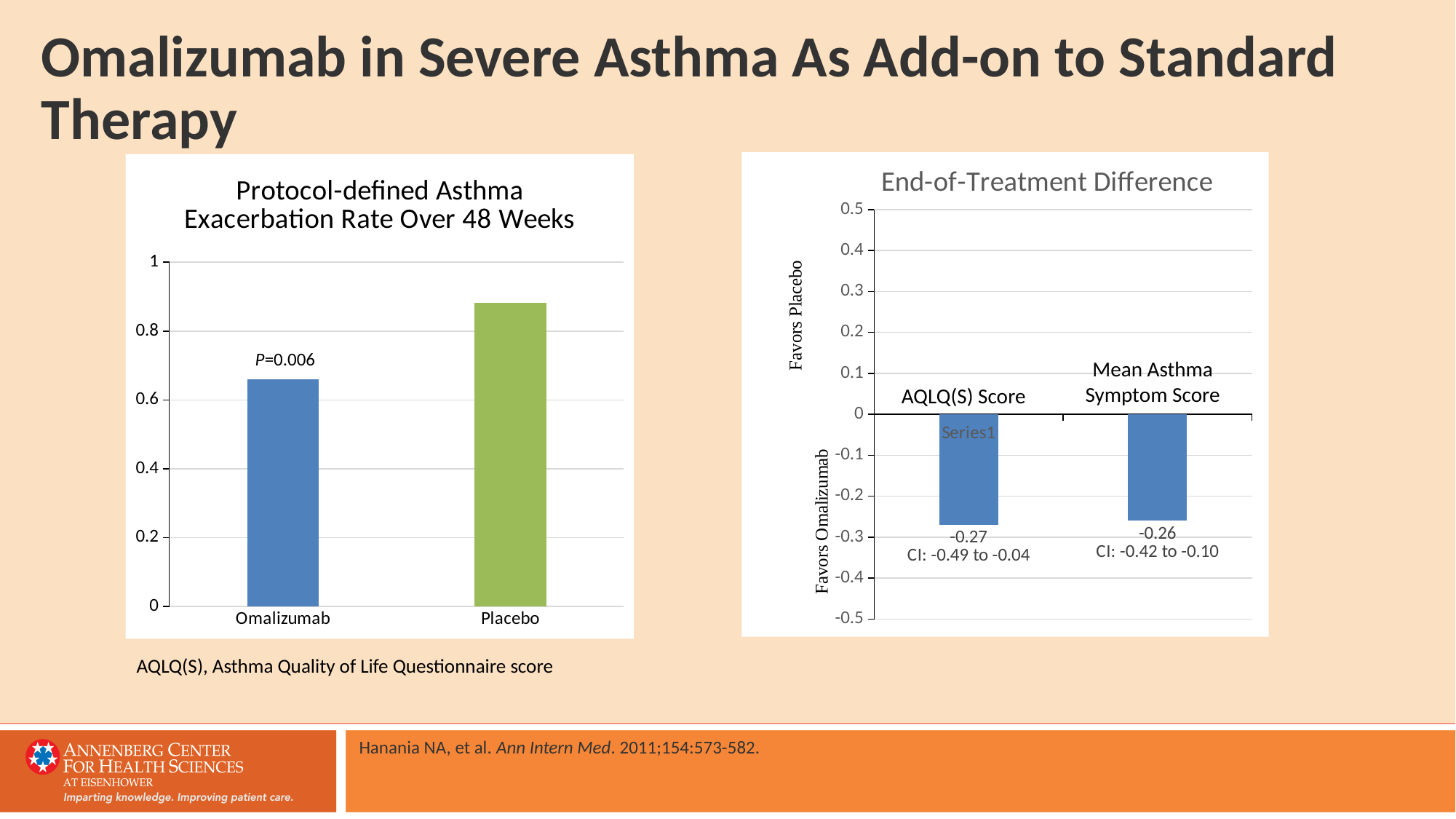
In the 'End-of-Treatment Difference' chart, what is the value for Mean Asthma Symptom Score? -0.26 In the 'Protocol-defined Asthma Exacerbation Rate Over 48 Weeks' chart, is the value for Placebo greater or less than 0.8? greater In the 'Protocol-defined Asthma Exacerbation Rate Over 48 Weeks' chart, how many categories are plotted? 2 In the 'End-of-Treatment Difference' chart, what confidence interval is printed for the AQLQ(S) Score? CI: -0.49 to -0.04 In the 'Protocol-defined Asthma Exacerbation Rate Over 48 Weeks' chart, which category has the highest exacerbation rate? Placebo In the 'End-of-Treatment Difference' chart, what is the difference between the AQLQ(S) Score value and the Mean Asthma Symptom Score value? 0.01 In the 'Protocol-defined Asthma Exacerbation Rate Over 48 Weeks' chart, which category has the lowest exacerbation rate? Omalizumab In the 'Protocol-defined Asthma Exacerbation Rate Over 48 Weeks' chart, is the value for Omalizumab greater or less than 0.8? less In the 'End-of-Treatment Difference' chart, how many categories are plotted? 2 What kind of chart is the 'Protocol-defined Asthma Exacerbation Rate Over 48 Weeks' chart? bar chart In the 'End-of-Treatment Difference' chart, what is the value for AQLQ(S) Score? -0.27 In the 'Protocol-defined Asthma Exacerbation Rate Over 48 Weeks' chart, what P value is printed above the Omalizumab bar? P=0.006